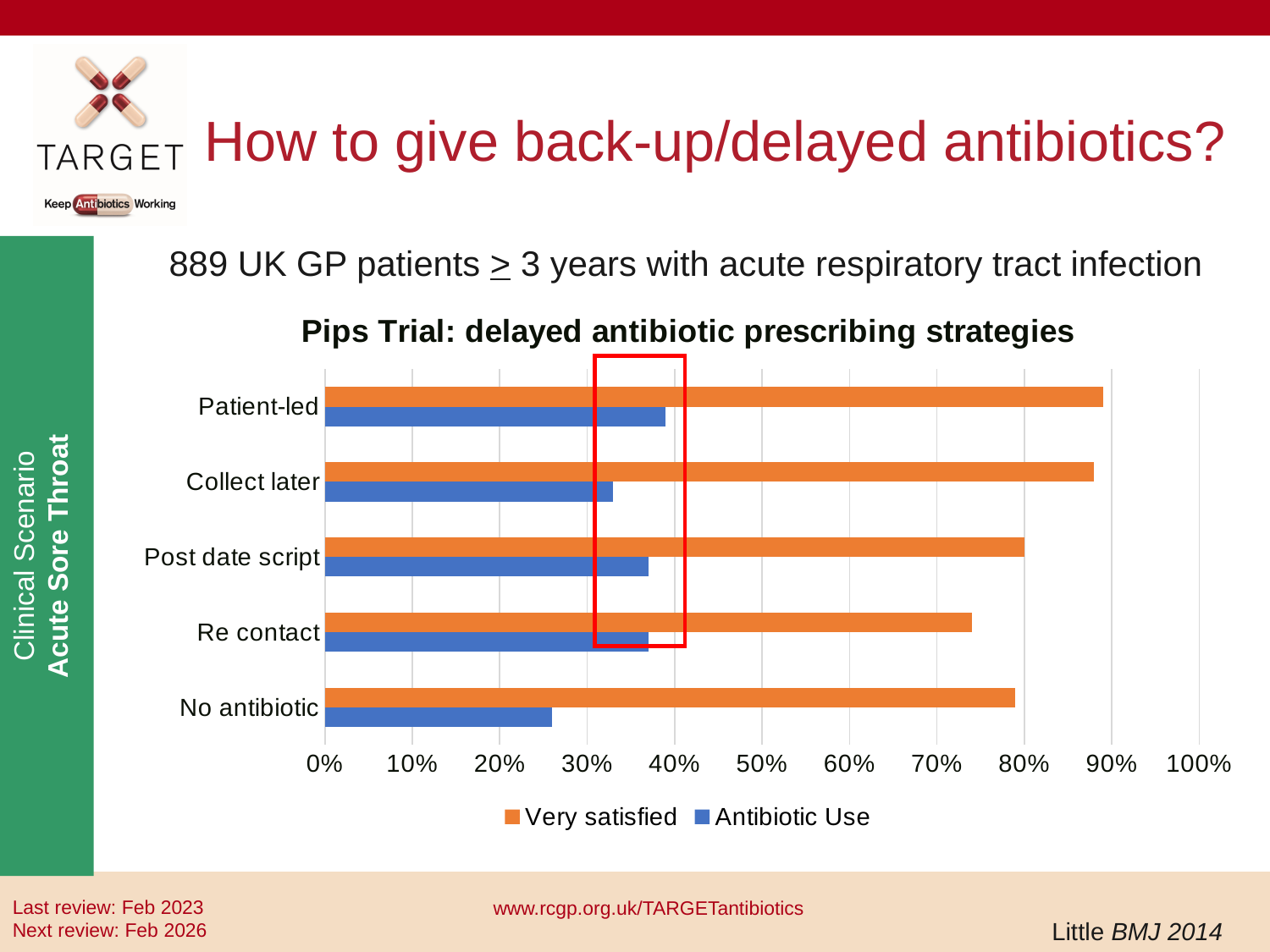
Which series is shown in orange? Very satisfied Is the Antibiotic Use value for No antibiotic greater or less than 30%? less What kind of chart is shown on the slide? Bar chart How many series does the chart legend list? 2 How many prescribing strategies (categories) are shown on the chart? 5 What is the title of the chart? Pips Trial: delayed antibiotic prescribing strategies Which strategy has the lowest Antibiotic Use value? No antibiotic Which strategy has the lowest Very satisfied value? Re contact Is the Very satisfied value for Patient-led greater or less than 80%? greater Is the Very satisfied value for Re contact greater or less than 80%? less For Collect later, which is larger: Very satisfied or Antibiotic Use? Very satisfied Which has the higher Very satisfied value, Patient-led or Re contact? Patient-led